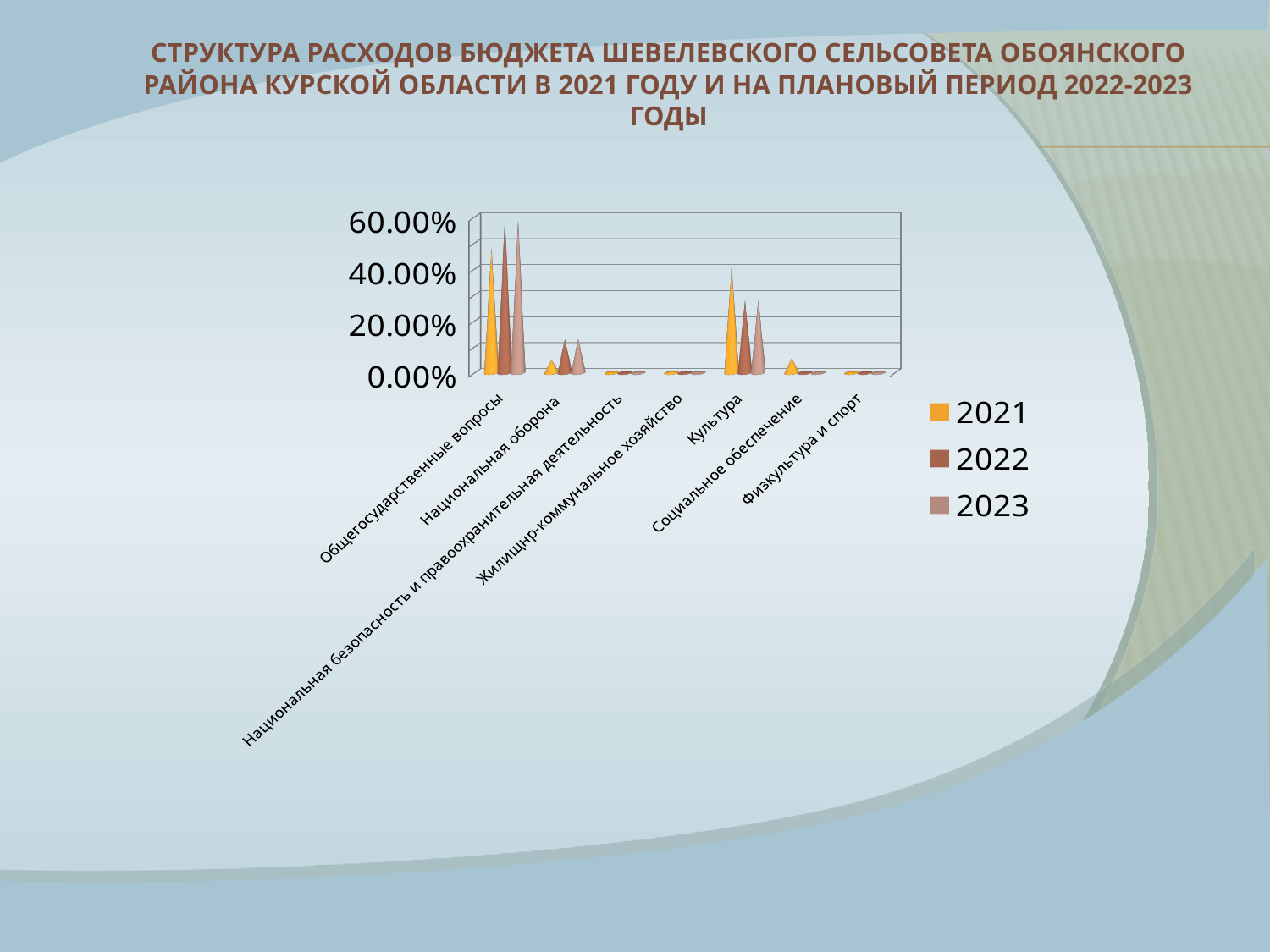
For the 2022 series, which is larger: Общегосударственные вопросы or Культура? Общегосударственные вопросы Which category has the highest value for the 2021 series? Общегосударственные вопросы How many expenditure categories are shown on the x axis of the chart? 7 Which years are listed in the chart legend? 2021, 2022, 2023 Is the 2021 value for Культура greater or less than 20.00%? greater Is the 2022 value for Национальная оборона greater or less than 20.00%? less Is the 2021 value for Общегосударственные вопросы greater or less than 40.00%? greater What kind of chart is shown on the slide? bar chart Which category has the highest value for the 2022 series? Общегосударственные вопросы For the 2021 series, which is larger: Культура or Национальная оборона? Культура How many series does the chart legend list? 3